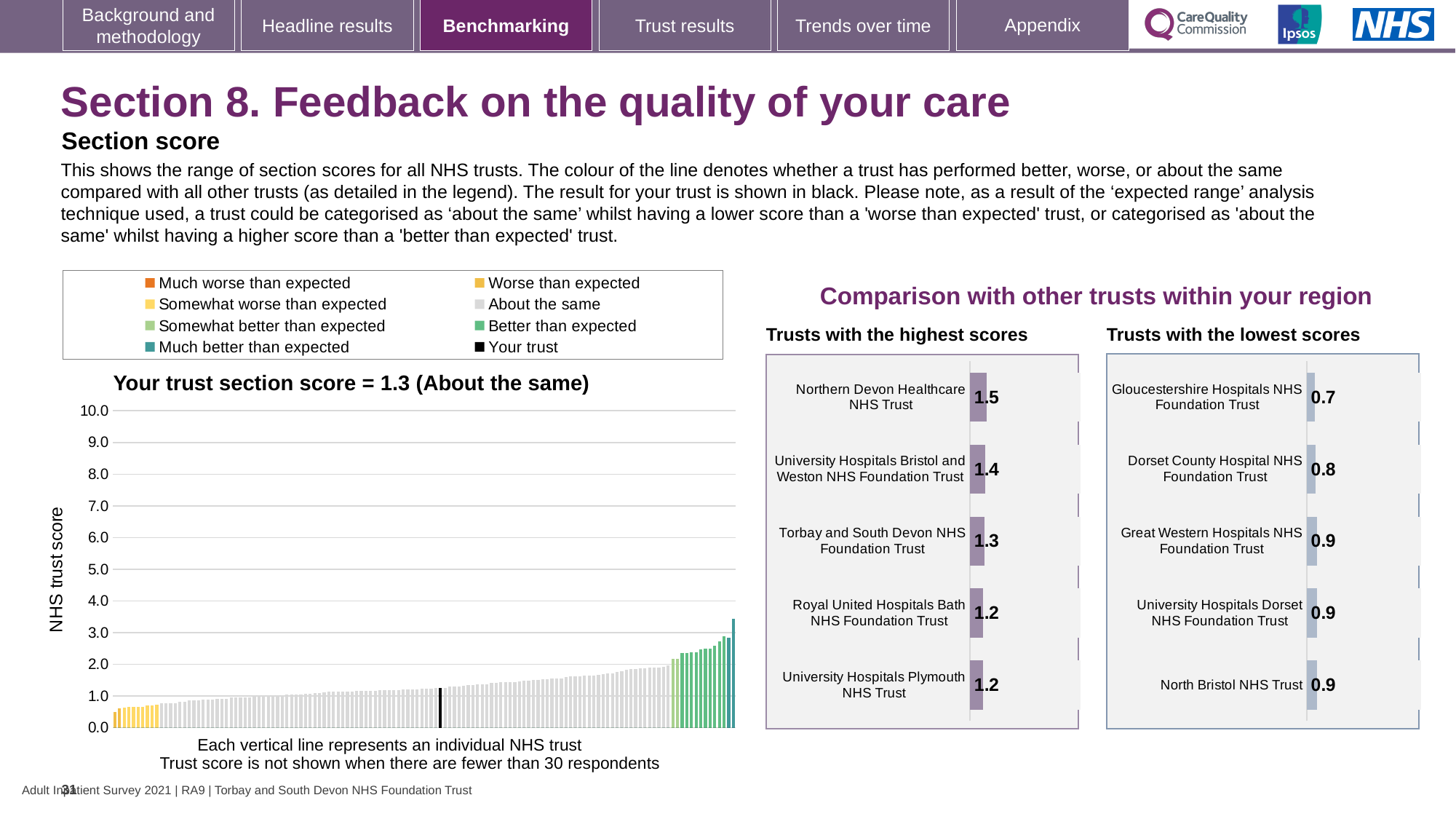
How many trusts are shown in the 'Trusts with the highest scores' chart? 5 According to the title of the main chart on the left, what is your trust's section score? 1.3 In the 'Trusts with the highest scores' chart, what is the difference between the scores of Northern Devon Healthcare NHS Trust and University Hospitals Plymouth NHS Trust? 0.3 In the 'Trusts with the lowest scores' chart, what is the score for Gloucestershire Hospitals NHS Foundation Trust? 0.7 In the 'Trusts with the highest scores' chart, what is the score for Northern Devon Healthcare NHS Trust? 1.5 In the 'Trusts with the highest scores' chart, what is the score for University Hospitals Bristol and Weston NHS Foundation Trust? 1.4 What kind of chart is the main chart on the left showing NHS trust scores? Bar chart In the 'Trusts with the lowest scores' chart, what is the score for Dorset County Hospital NHS Foundation Trust? 0.8 In the 'Trusts with the lowest scores' chart, which trust has the lowest score? Gloucestershire Hospitals NHS Foundation Trust In the 'Trusts with the lowest scores' chart, which has the larger score: Gloucestershire Hospitals NHS Foundation Trust or North Bristol NHS Trust? North Bristol NHS Trust In the 'Trusts with the highest scores' chart, which trust has the highest score? Northern Devon Healthcare NHS Trust In the main chart on the left, do the trust scores rise or fall from left to right along the x axis? Rise